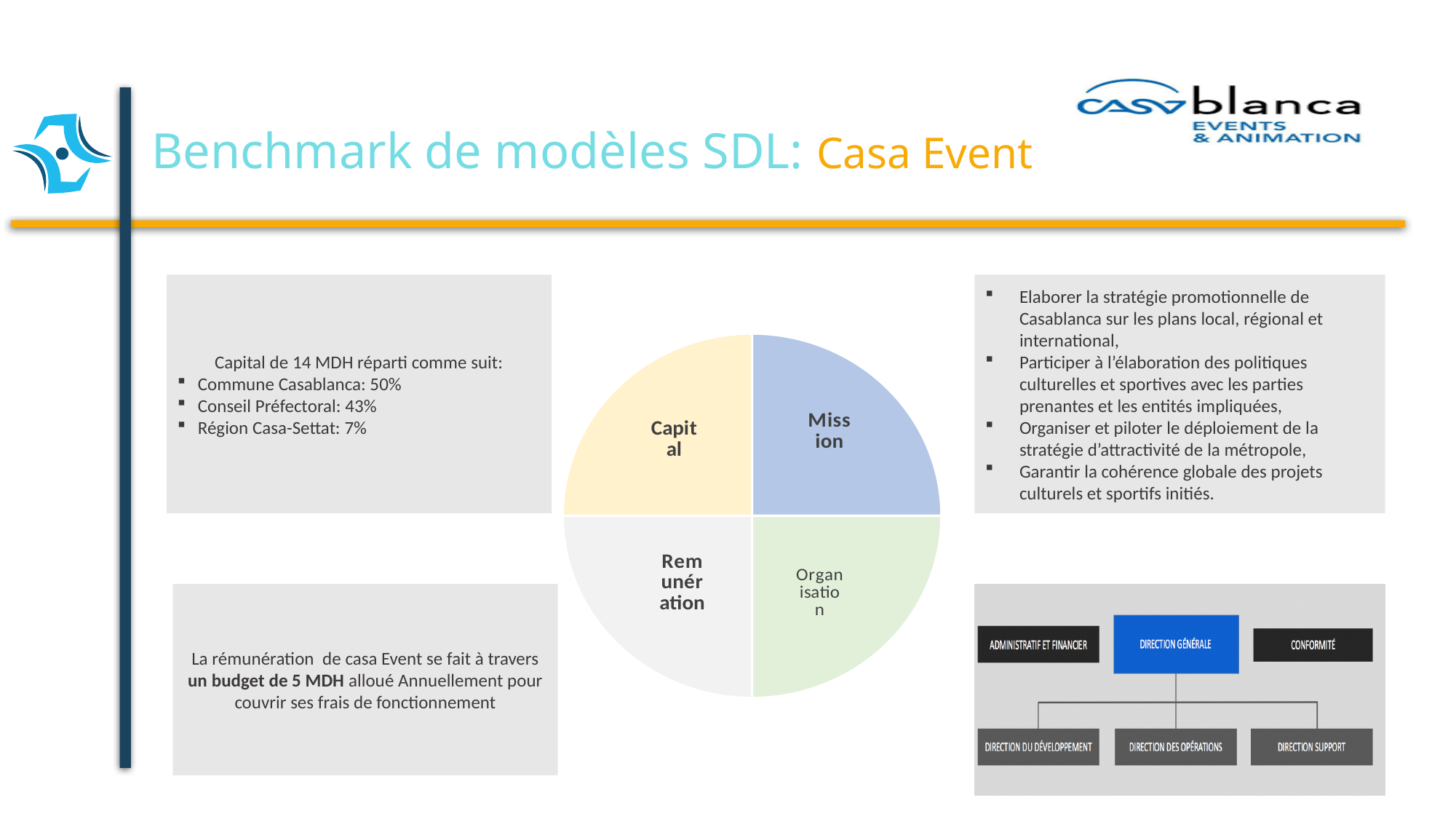
Which slice of the pie chart is in the bottom-left quadrant? Remunération What kind of chart is shown in the centre of the slide? pie chart How many slices does the pie chart have? 4 Which slice of the pie chart is coloured blue? Mission Do the four slices of the pie chart appear to be equal in size? yes Which slice of the pie chart is in the bottom-right quadrant? Organisation Which slice of the pie chart is coloured yellow? Capital